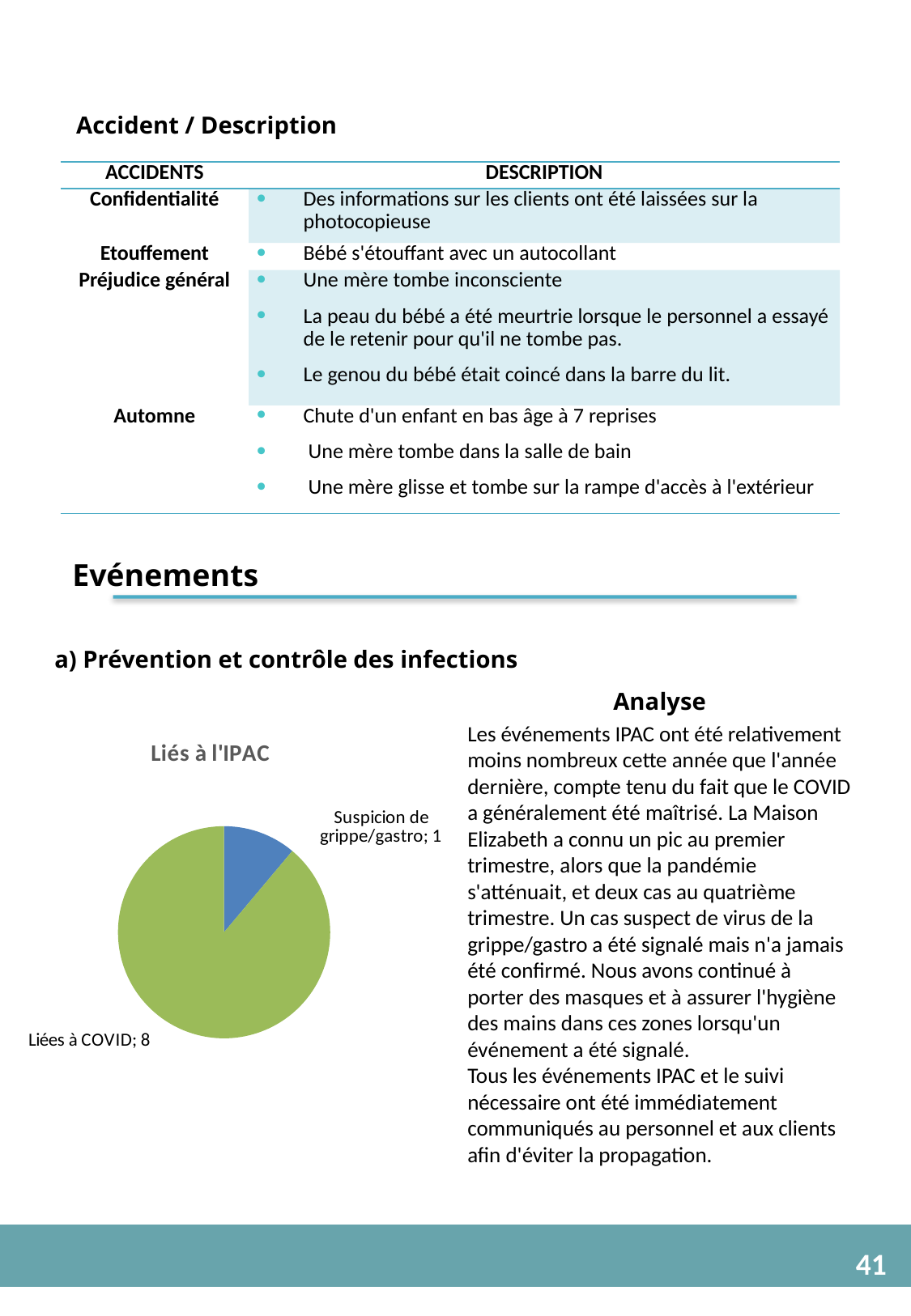
In the 'Liés à l'IPAC' pie chart, what is the value for 'Suspicion de grippe/gastro'? 1 What is the total of all slices in the 'Liés à l'IPAC' pie chart? 9 What kind of chart is shown under 'a) Prévention et contrôle des infections'? Pie chart In the 'Liés à l'IPAC' pie chart, what is the value for 'Liées à COVID'? 8 Which category has the smallest slice in the 'Liés à l'IPAC' pie chart? Suspicion de grippe/gastro What is the difference between the 'Liées à COVID' value and the 'Suspicion de grippe/gastro' value in the pie chart? 7 What fraction of the total events in the 'Liés à l'IPAC' pie chart does 'Liées à COVID' represent? 8 out of 9 Which is larger in the 'Liés à l'IPAC' pie chart: 'Liées à COVID' or 'Suspicion de grippe/gastro'? Liées à COVID How many categories are shown in the 'Liés à l'IPAC' pie chart? 2 Which category has the largest slice in the 'Liés à l'IPAC' pie chart? Liées à COVID What colour is the 'Liées à COVID' slice in the pie chart? Green What is the title of the pie chart? Liés à l'IPAC